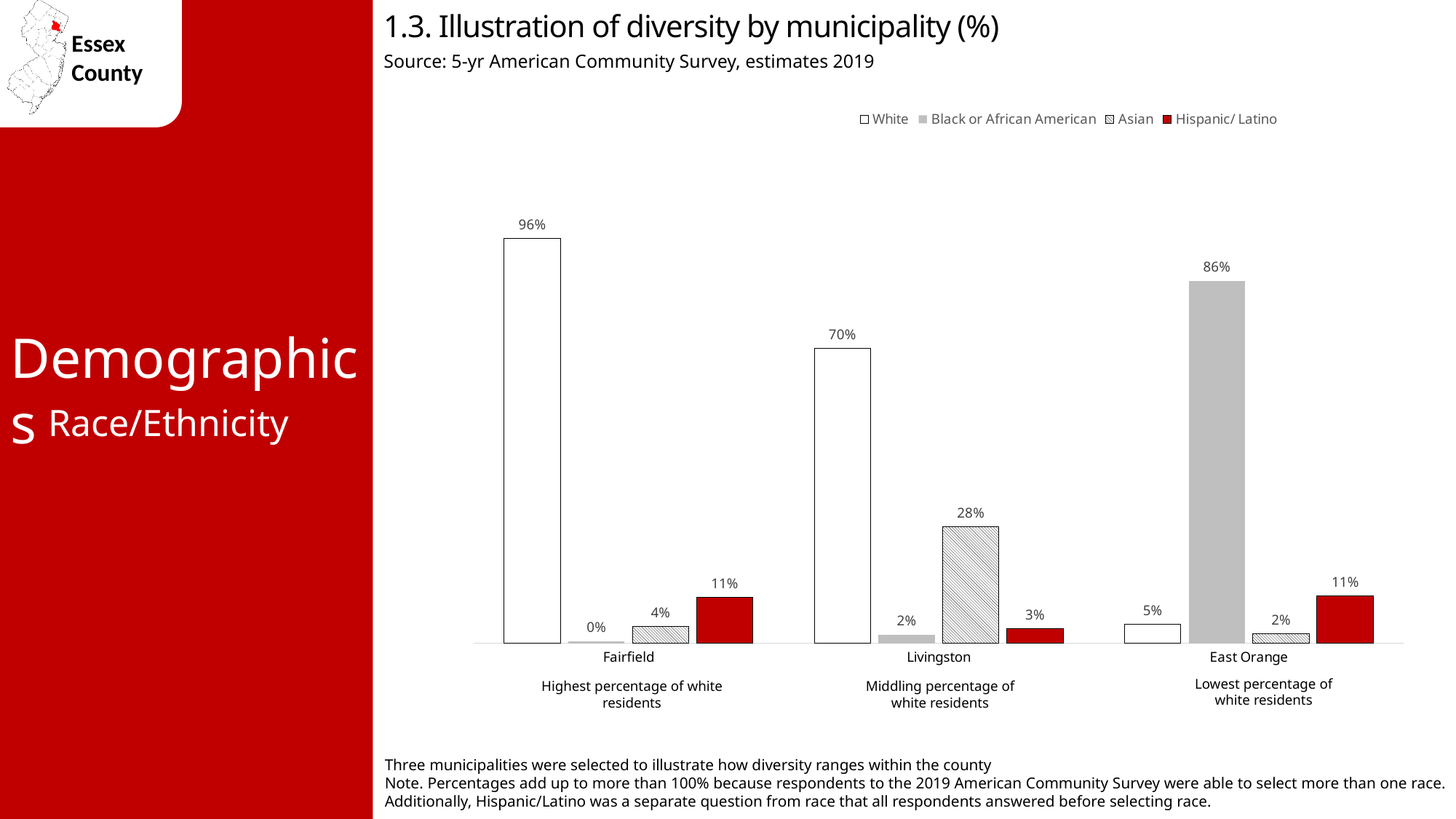
Which municipality has the highest value for White? Fairfield What is the value for White in Fairfield? 96% What is the value for Asian in Livingston? 28% What kind of chart is shown on the slide? Bar chart What is the difference between the White value in Fairfield and the White value in Livingston? 26% How many municipalities are shown on the x axis? 3 Which is larger, the Asian value in Livingston or the Asian value in East Orange? Livingston Which municipality has the lowest value for Black or African American? Fairfield What is the value for Black or African American in East Orange? 86% What is the value for Hispanic/ Latino in Livingston? 3% How many series does the legend list? 4 What is the title of the chart? 1.3. Illustration of diversity by municipality (%)